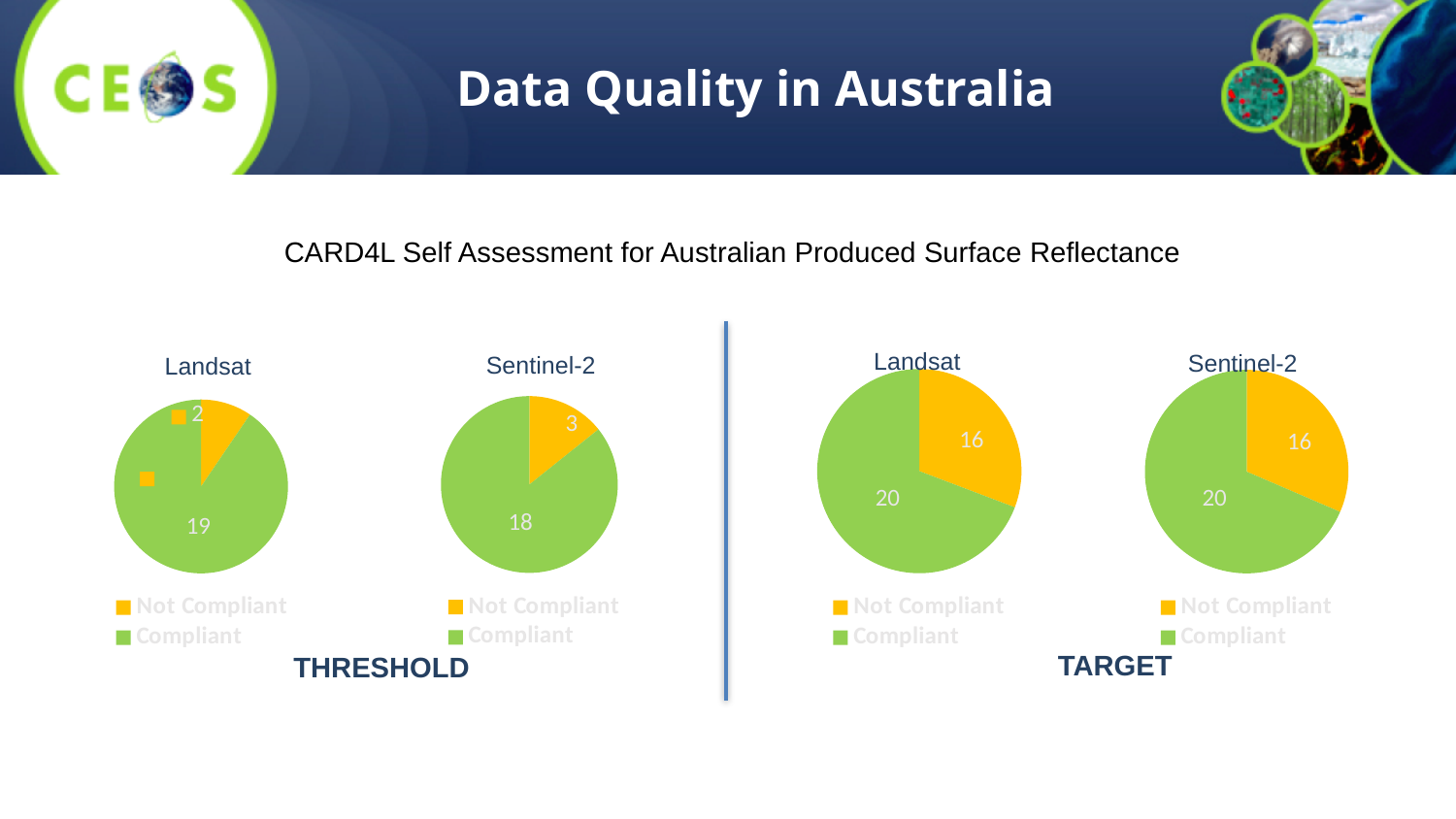
In the THRESHOLD Landsat pie chart, which colour represents the Not Compliant slice? Yellow In the TARGET Sentinel-2 pie chart, how many items are Compliant? 20 In the THRESHOLD Landsat pie chart, what is the difference between the Compliant and Not Compliant counts? 17 In the THRESHOLD Landsat pie chart, how many items are Compliant? 19 In the THRESHOLD Sentinel-2 pie chart, which slice is larger, Compliant or Not Compliant? Compliant In the TARGET Landsat pie chart, what is the total number of items across both slices? 36 In the TARGET Landsat pie chart, how many items are Not Compliant? 16 How many entries does the legend of the TARGET Sentinel-2 pie chart list? 2 In the THRESHOLD Sentinel-2 pie chart, how many items are Not Compliant? 3 In the THRESHOLD Landsat pie chart, how many items are Not Compliant? 2 In the THRESHOLD Sentinel-2 pie chart, how many items are Compliant? 18 What type of chart is used for the THRESHOLD Landsat assessment? Pie chart